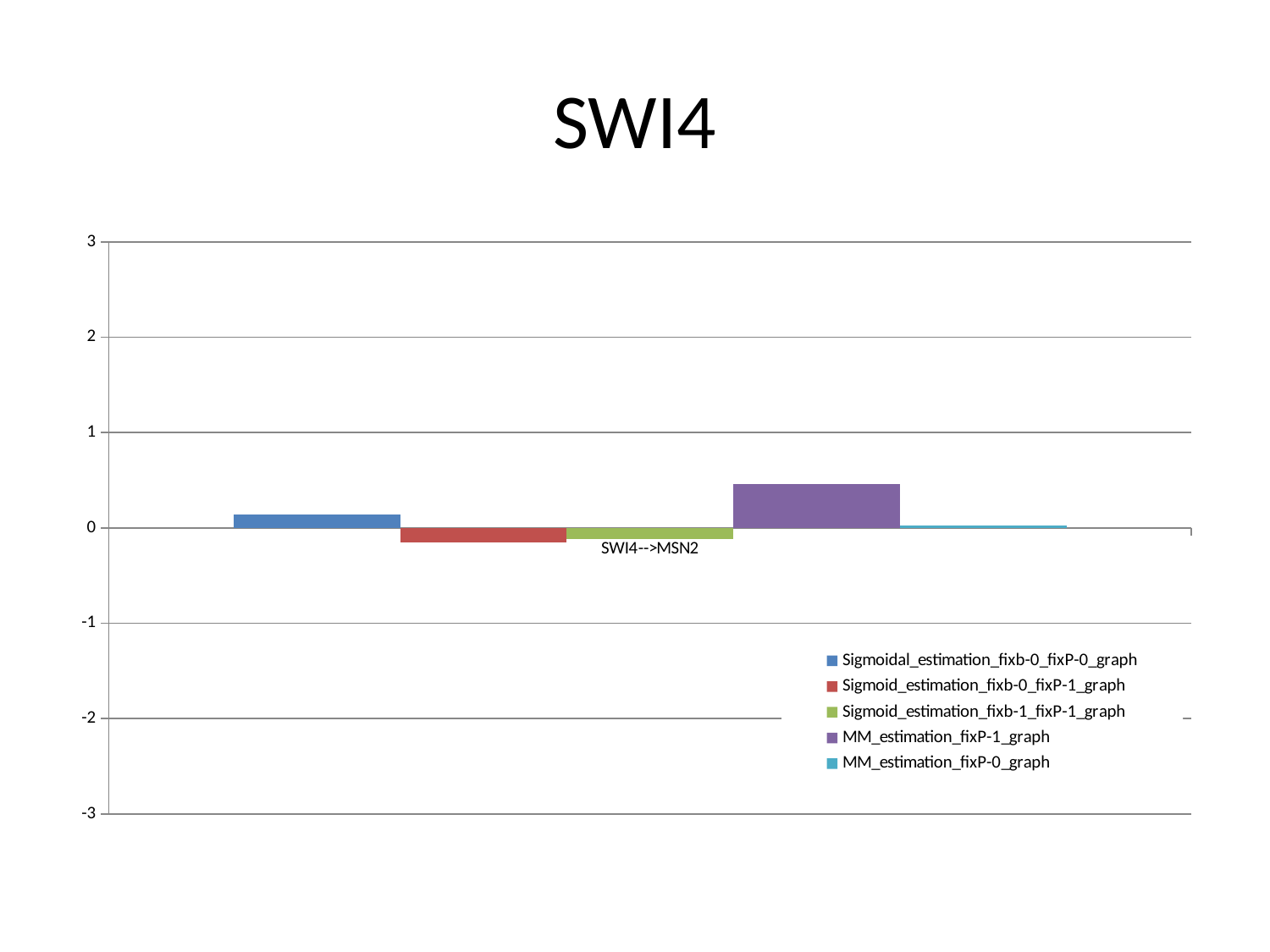
Is the value for Sigmoidal_estimation_fixb-0_fixP-0_graph greater or less than 1? less Which series has the highest value for SWI4-->MSN2? MM_estimation_fixP-1_graph How many series does the legend list? 5 Is the value for MM_estimation_fixP-1_graph greater or less than 1? less What kind of chart is shown on the slide? bar chart Is the value for Sigmoid_estimation_fixb-0_fixP-1_graph greater or less than 0? less What is the label of the category on the x axis? SWI4-->MSN2 Which is larger, the value for MM_estimation_fixP-1_graph or the value for Sigmoidal_estimation_fixb-0_fixP-0_graph? MM_estimation_fixP-1_graph How many categories are shown on the x axis? 1 What is the title of the chart? SWI4 Which is larger, the value for Sigmoidal_estimation_fixb-0_fixP-0_graph or the value for Sigmoid_estimation_fixb-0_fixP-1_graph? Sigmoidal_estimation_fixb-0_fixP-0_graph